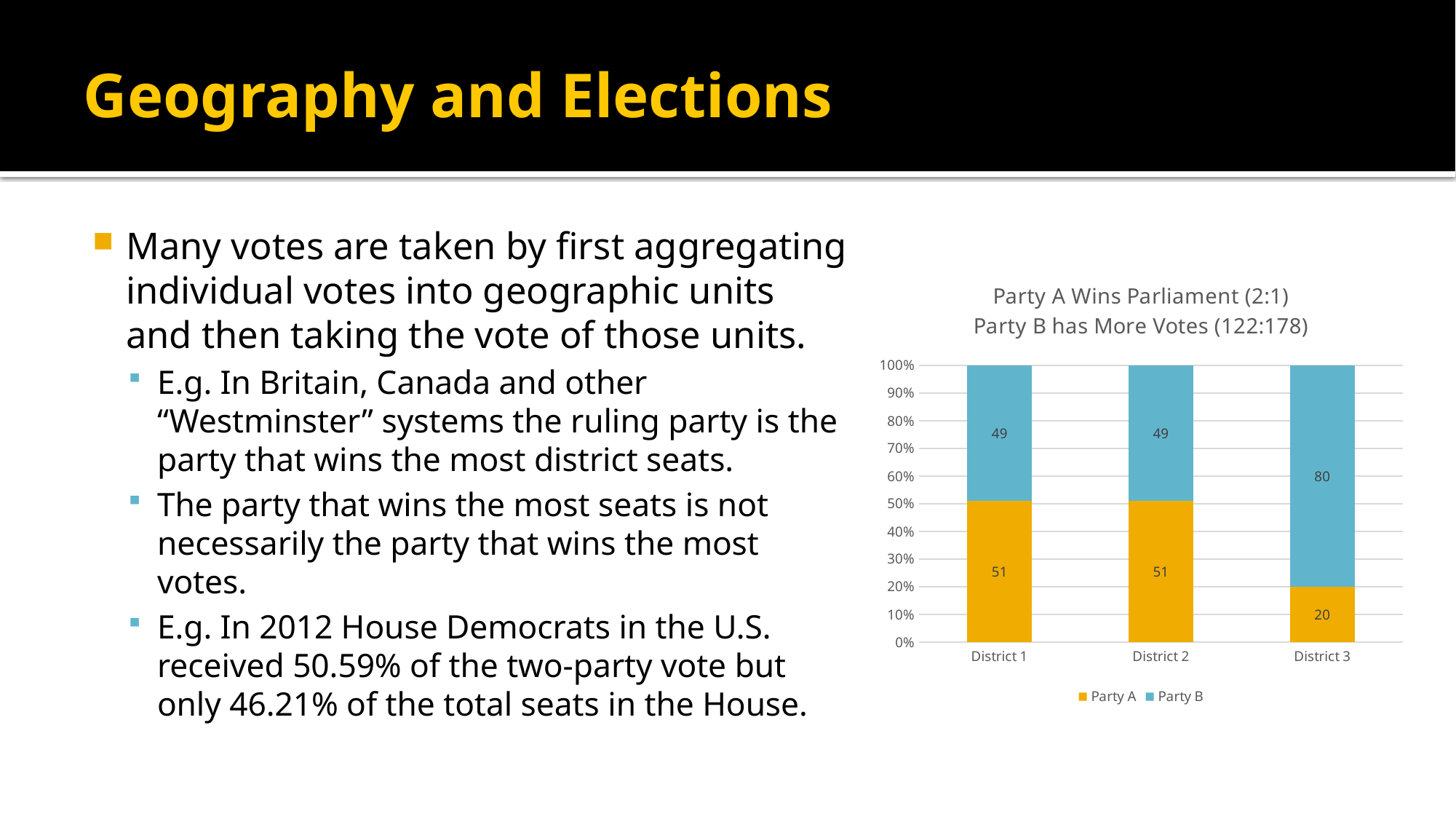
What is the value for Party B in District 2? 49 What is the value for Party A in District 1? 51 What is the value for Party B in District 3? 80 What is the difference between Party B and Party A in District 3? 60 How many districts are shown on the x axis? 3 What is the total of the stacked bar for District 3? 100 In which district is the value for Party B highest? District 3 What kind of chart is shown on the slide? Stacked bar chart In District 2, which party has the larger value, Party A or Party B? Party A In which district is the value for Party A lowest? District 3 What is the value for Party A in District 3? 20 How many series does the legend list? 2